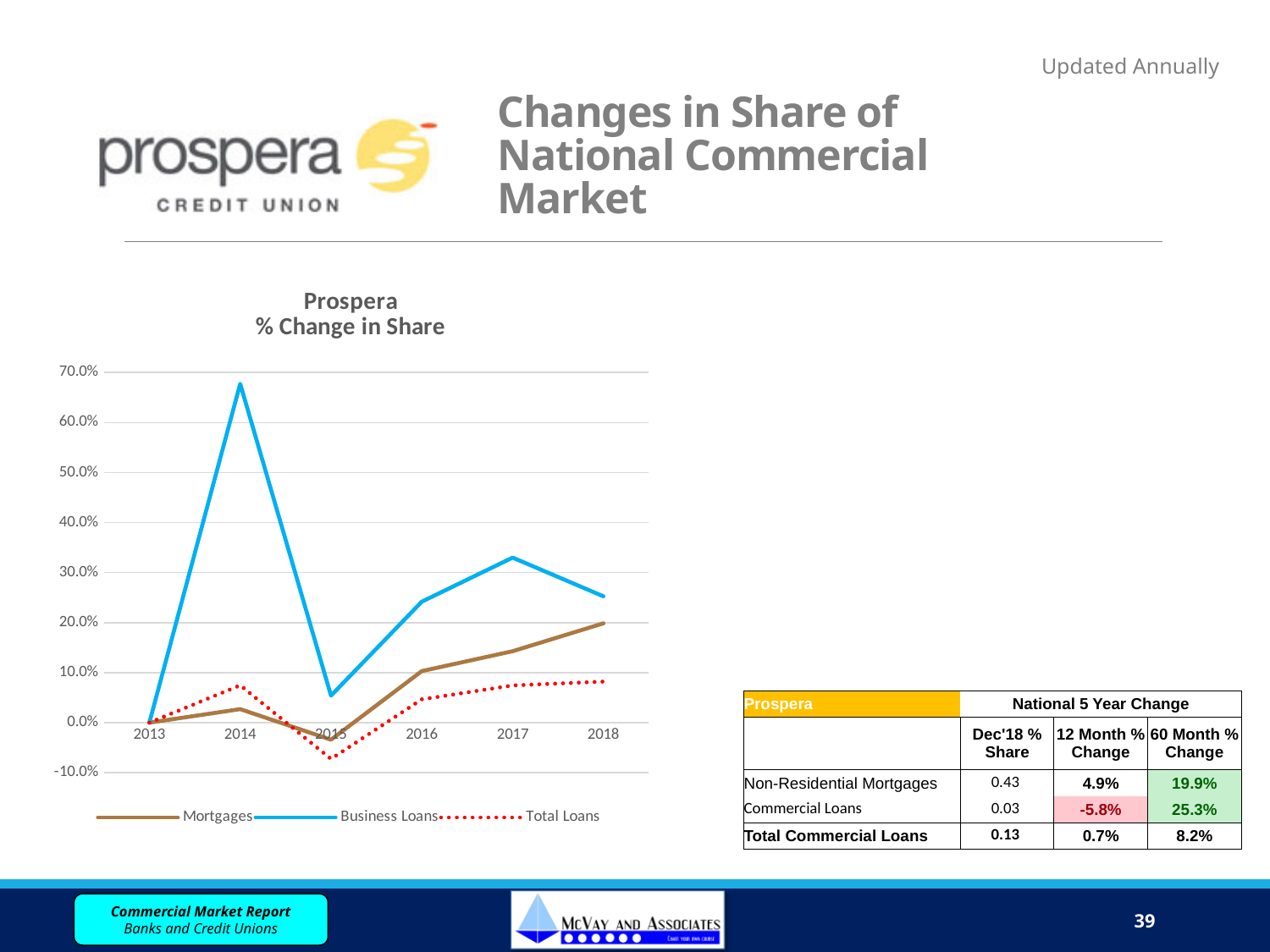
In which year does the Mortgages line reach its lowest value? 2015 Which series has the highest value in 2018? Business Loans How many years are shown on the x axis of the chart? 6 Is the value for Total Loans in 2015 greater or less than 0.0%? less In 2018, which is larger: Mortgages or Total Loans? Mortgages Which series is drawn as a dotted line? Total Loans Is the value for Business Loans in 2014 greater or less than 60.0%? greater Is the value for Mortgages in 2018 greater or less than 10.0%? greater What kind of chart is shown on the slide? line chart How many series does the legend of the chart list? 3 In which year does the Business Loans line reach its highest value? 2014 Does the Mortgages line rise or fall from 2015 to 2018? rise